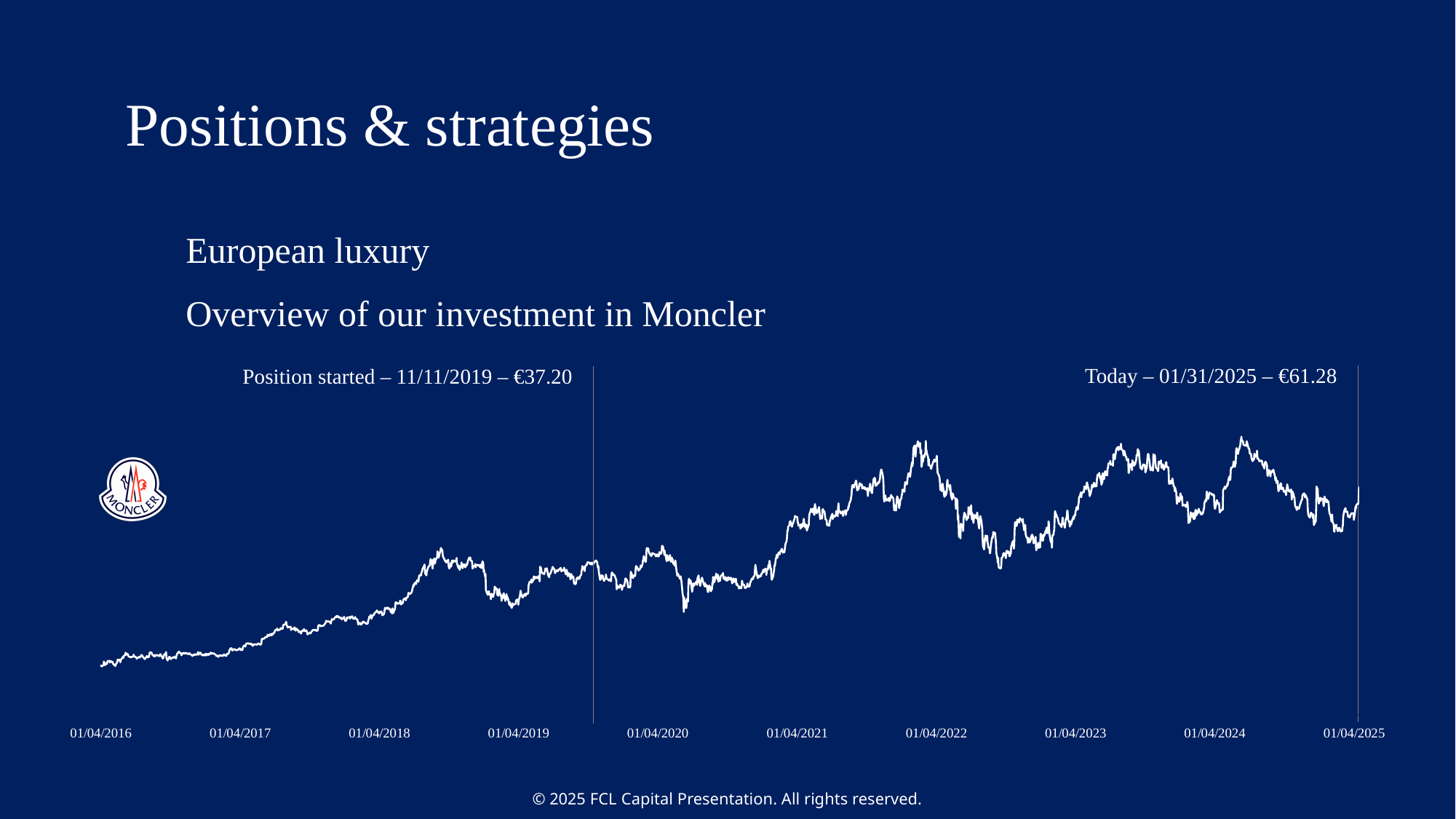
What is the difference between the 'Today' price and the price when the position was started? €24.08 What was the Moncler share price when the position was started? €37.20 What is the title of the slide? Positions & strategies Does the share price generally rise or fall from 01/04/2016 to 01/04/2025? rise How many date labels are shown on the x axis? 10 What is the first date label on the x axis? 01/04/2016 Which is higher: the price when the position started or the 'Today' price? Today – €61.28 What type of chart is shown on the slide? line chart Which company's share price does the chart show? Moncler On what date was the Moncler position started? 11/11/2019 What is the Moncler share price marked as 'Today' on the chart? €61.28 What date is labelled as 'Today' on the chart? 01/31/2025